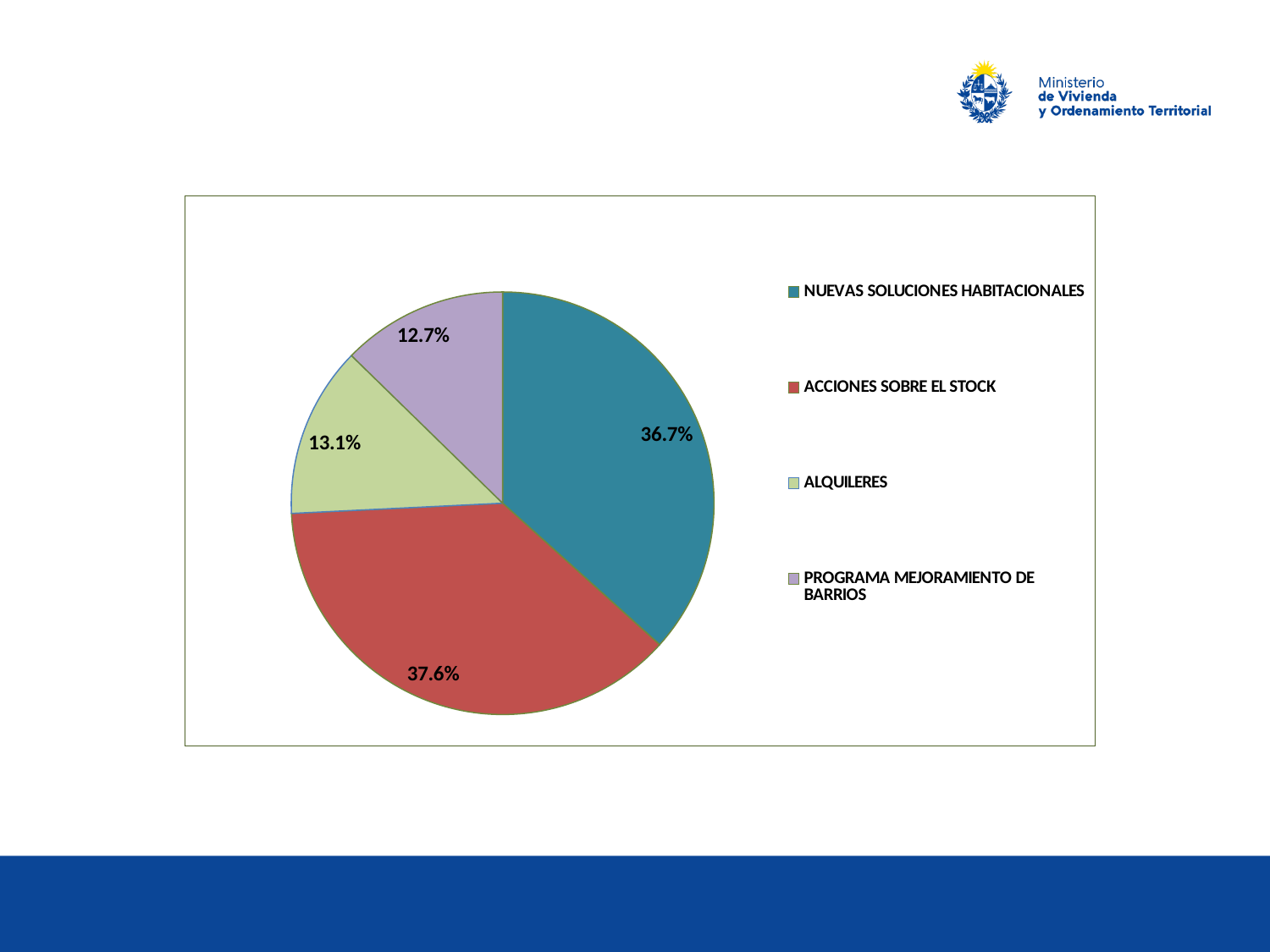
What is the difference in percentage points between ALQUILERES and PROGRAMA MEJORAMIENTO DE BARRIOS? 0.4 What share of the pie does NUEVAS SOLUCIONES HABITACIONALES represent? 36.7% Which category has the smallest slice of the pie? PROGRAMA MEJORAMIENTO DE BARRIOS What share of the pie does ACCIONES SOBRE EL STOCK represent? 37.6% What share of the pie does ALQUILERES represent? 13.1% How many slices does the pie chart have? 4 What is the difference in percentage points between ACCIONES SOBRE EL STOCK and NUEVAS SOLUCIONES HABITACIONALES? 0.9 Which category has the largest slice of the pie? ACCIONES SOBRE EL STOCK What kind of chart is shown on the slide? Pie chart Which is larger, the share for ALQUILERES or the share for PROGRAMA MEJORAMIENTO DE BARRIOS? ALQUILERES What colour is the slice for ALQUILERES? Light green